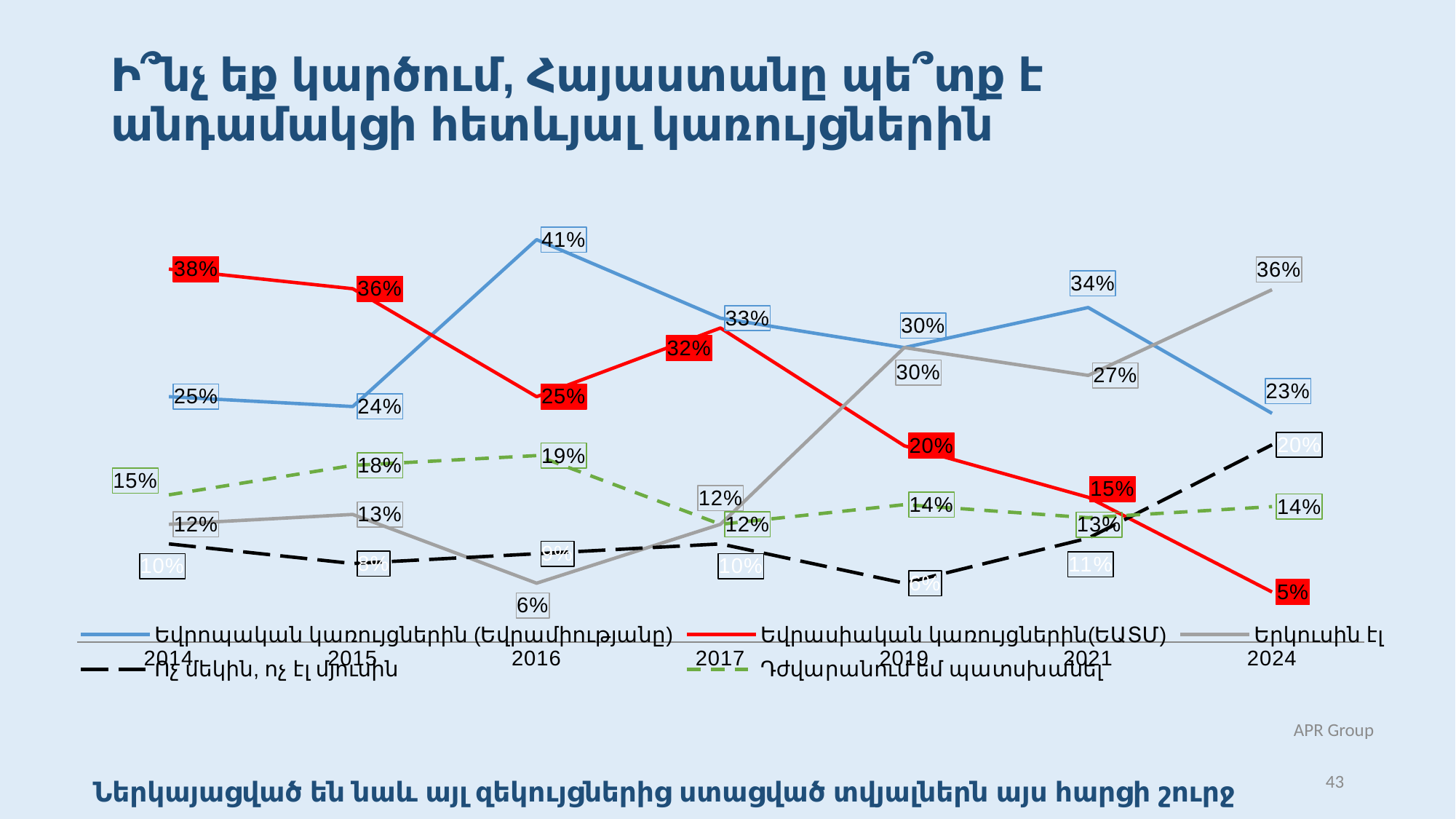
What is the value of the green dashed line (Դժվարանում եմ պատասխանել) in 2015? 18% In 2019, which is larger: the blue line (Եվրոպական կառույցներին) or the red line (Եվրասիական կառույցներին)? the blue line (Եվրոպական կառույցներին) What is the value of the gray line (Երկուսին էլ) in 2024? 36% What is the difference between the blue line and the red line in 2024? 18% How many series does the legend list? 5 What type of chart is shown on the slide? line chart In which year does the blue line (Եվրոպական կառույցներին (Եվրամիությանը)) reach its highest value? 2016 In which year does the red line (Եվրասիական կառույցներին (ԵԱՏՄ)) reach its lowest value? 2024 How many years are shown on the x axis? 7 What is the value of the red line (Եվրասիական կառույցներին (ԵԱՏՄ)) in 2014? 38% Does the red line (Եվրասիական կառույցներին (ԵԱՏՄ)) generally rise or fall from 2014 to 2024? fall What is the value of the blue line (Եվրոպական կառույցներին (Եվրամիությանը)) in 2016? 41%